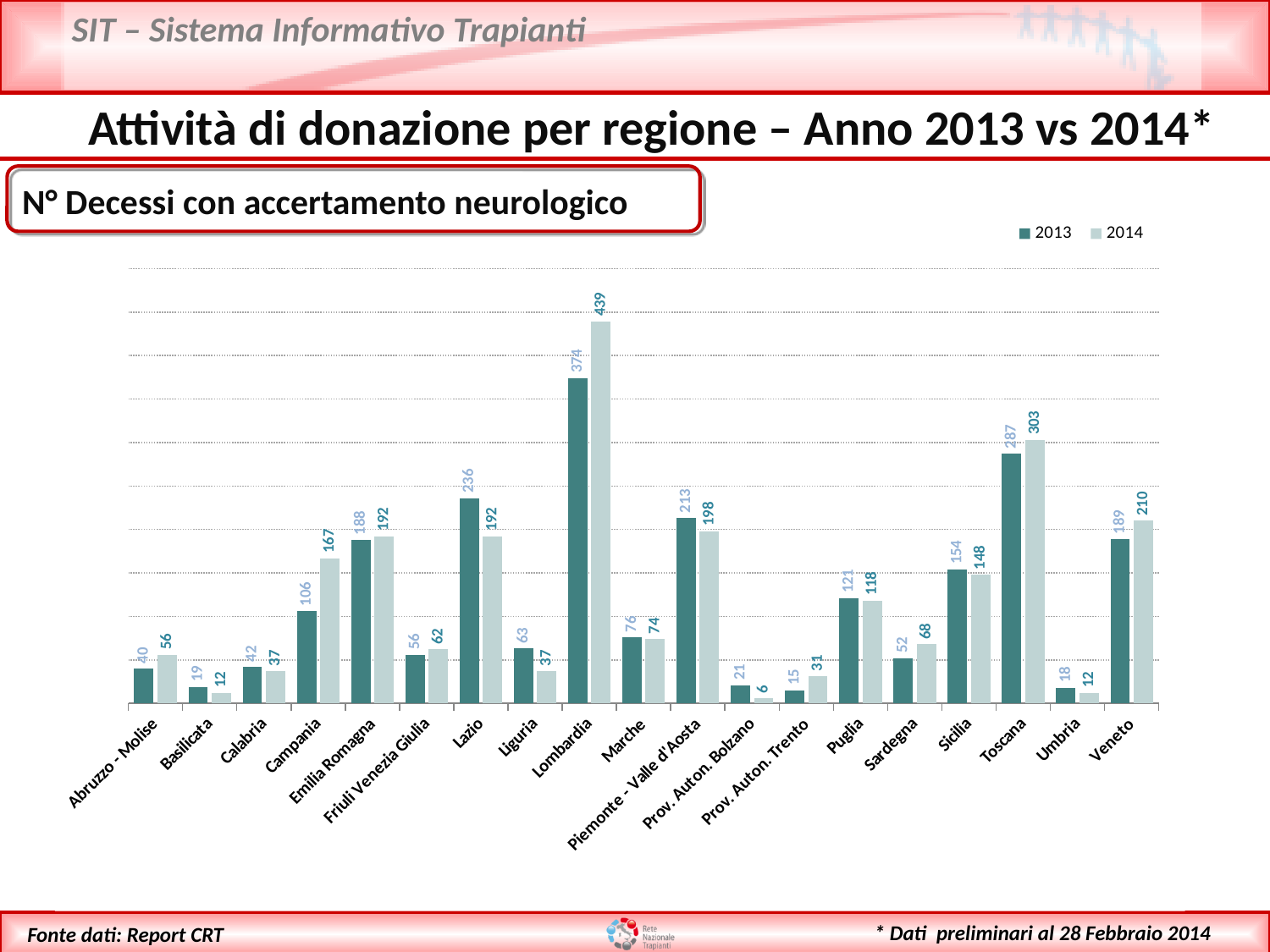
How many regions are shown on the x axis? 19 What is the difference between the 2013 and 2014 values for Lazio? 44 Which is larger for Veneto, the 2013 value or the 2014 value? 2014 Which region has the highest 2013 value? Lombardia What is the 2014 value for Campania? 167 What is the 2014 value for Lombardia? 439 What kind of chart is shown on the slide? Bar chart What is the 2013 value for Lazio? 236 How many series does the legend list? 2 Which is larger for Liguria, the 2013 value or the 2014 value? 2013 What is the difference between the 2014 and 2013 values for Toscana? 16 Which region has the lowest 2014 value? Prov. Auton. Bolzano